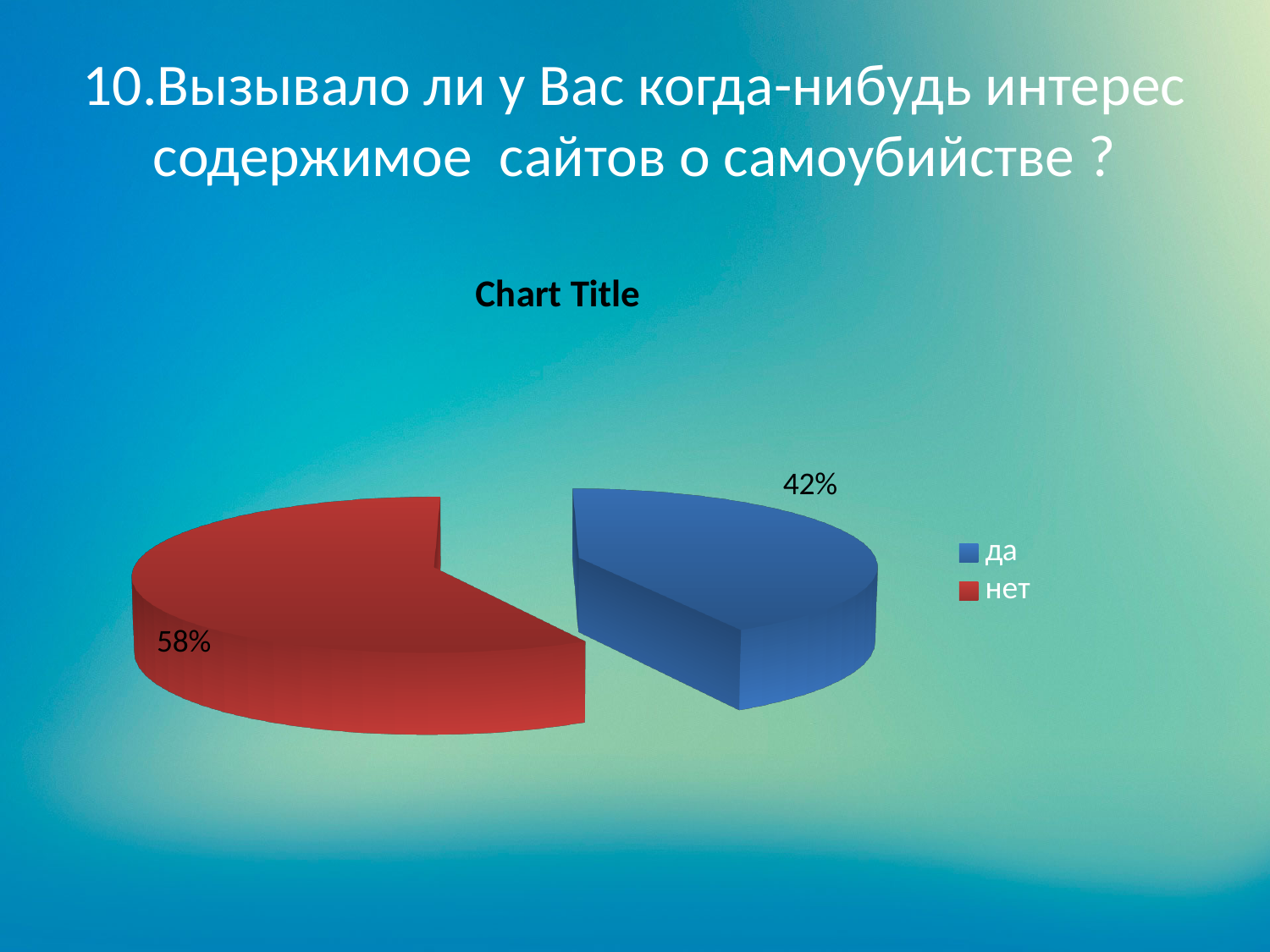
Which category has the smallest share of the pie? да What percentage is shown for the "нет" slice? 58% What percentage is shown for the "да" slice? 42% What is the title printed above the chart? Chart Title How many entries does the legend list? 2 Which is larger, the share for "да" or the share for "нет"? нет What kind of chart is shown on the slide? pie chart What share of the pie does the "да" slice represent? 42% Which category has the largest share of the pie? нет What is the difference between the "нет" and "да" shares? 16% How many slices does the pie chart have? 2 What colour is the "нет" slice? red